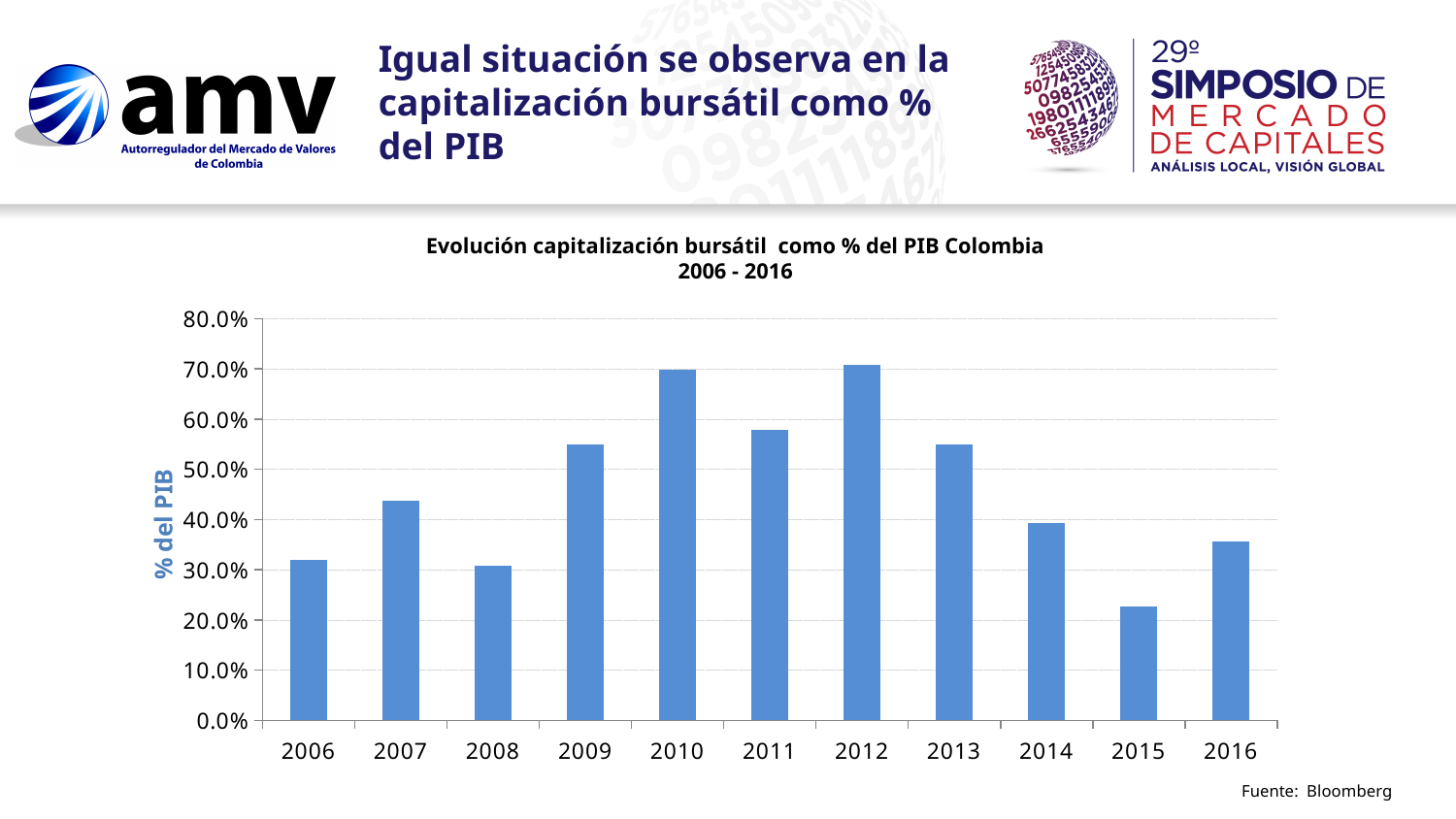
Which is larger, the value for 2011 or the value for 2014? 2011 What is the title of the chart? Evolución capitalización bursátil como % del PIB Colombia 2006 - 2016 What kind of chart is shown on the slide? bar chart How many years are plotted on the x axis of the chart? 11 Which is larger, the value for 2008 or the value for 2016? 2016 Is the value for 2006 greater or less than 40.0%? less Is the value for 2010 greater or less than 60.0%? greater Is the value for 2014 greater or less than 30.0%? greater Which year has the lowest capitalización bursátil as % del PIB? 2015 Do the values rise or fall from 2012 to 2015? fall